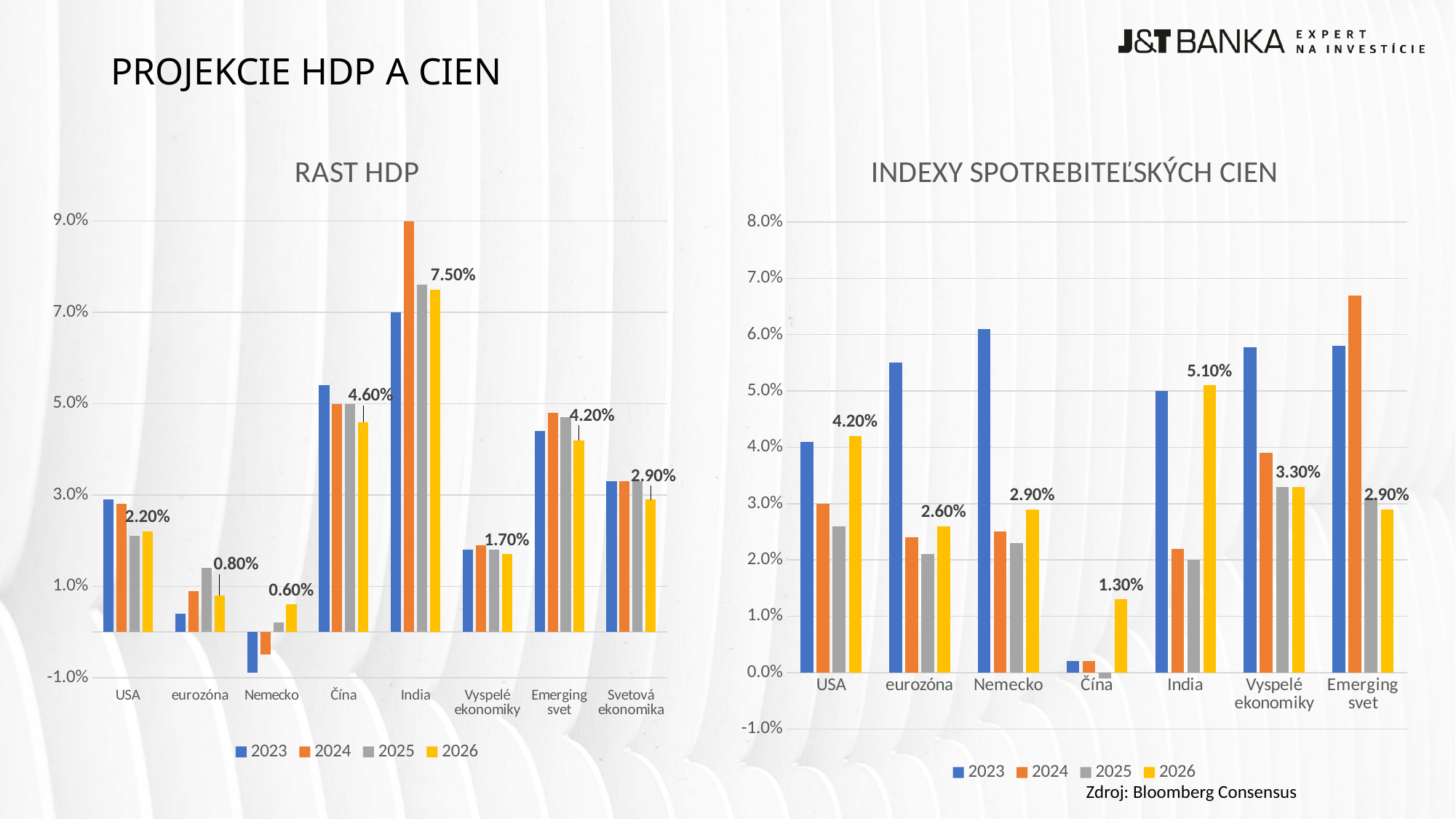
What kind of chart is the RAST HDP chart? bar chart In the RAST HDP chart, which category has the highest 2026 value? India How many series does the legend of the INDEXY SPOTREBITEĽSKÝCH CIEN chart list? 4 In the RAST HDP chart, what is the 2026 value for India? 7.50% In the INDEXY SPOTREBITEĽSKÝCH CIEN chart, which category has the lowest 2026 value? Čína In the INDEXY SPOTREBITEĽSKÝCH CIEN chart, what is the 2026 value for USA? 4.20% How many categories are shown on the x axis of the RAST HDP chart? 8 In the INDEXY SPOTREBITEĽSKÝCH CIEN chart, which is larger for 2026: India or Vyspelé ekonomiky? India In the RAST HDP chart, what is the difference between the 2026 values for India and Čína? 2.90% In the RAST HDP chart, is the 2024 value for India greater or less than 7.0%? greater In the INDEXY SPOTREBITEĽSKÝCH CIEN chart, is the 2024 value for Emerging svet greater or less than 6.0%? greater In the RAST HDP chart, which category has the lowest 2026 value? Nemecko